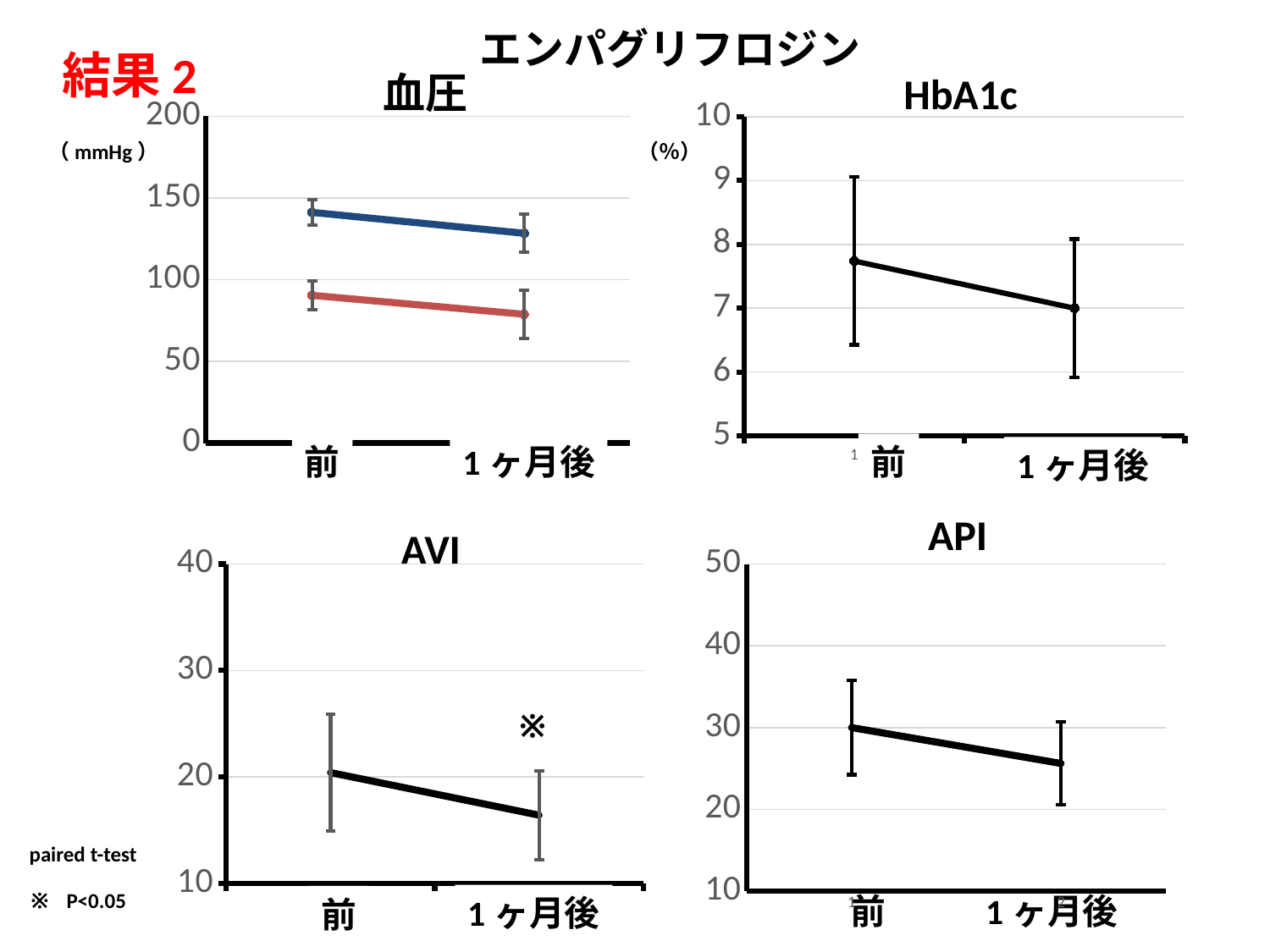
In the 血圧 chart, is the value of the blue line at 前 greater or less than 100? greater In the API chart, does the value rise or fall from 前 to 1ヶ月後? fall What kind of chart is the 血圧 chart? line chart What unit is shown on the y axis of the 血圧 chart? mmHg In the HbA1c chart, does the value rise or fall from 前 to 1ヶ月後? fall In the AVI chart, is the value at 1ヶ月後 greater or less than 20? less In the 血圧 chart, does the blue line rise or fall from 前 to 1ヶ月後? fall In the 血圧 chart, is the value of the red line at 前 greater or less than 100? less In the 血圧 chart, how many points are on the x axis? 2 In the AVI chart, which is larger, the value at 前 or at 1ヶ月後? 前